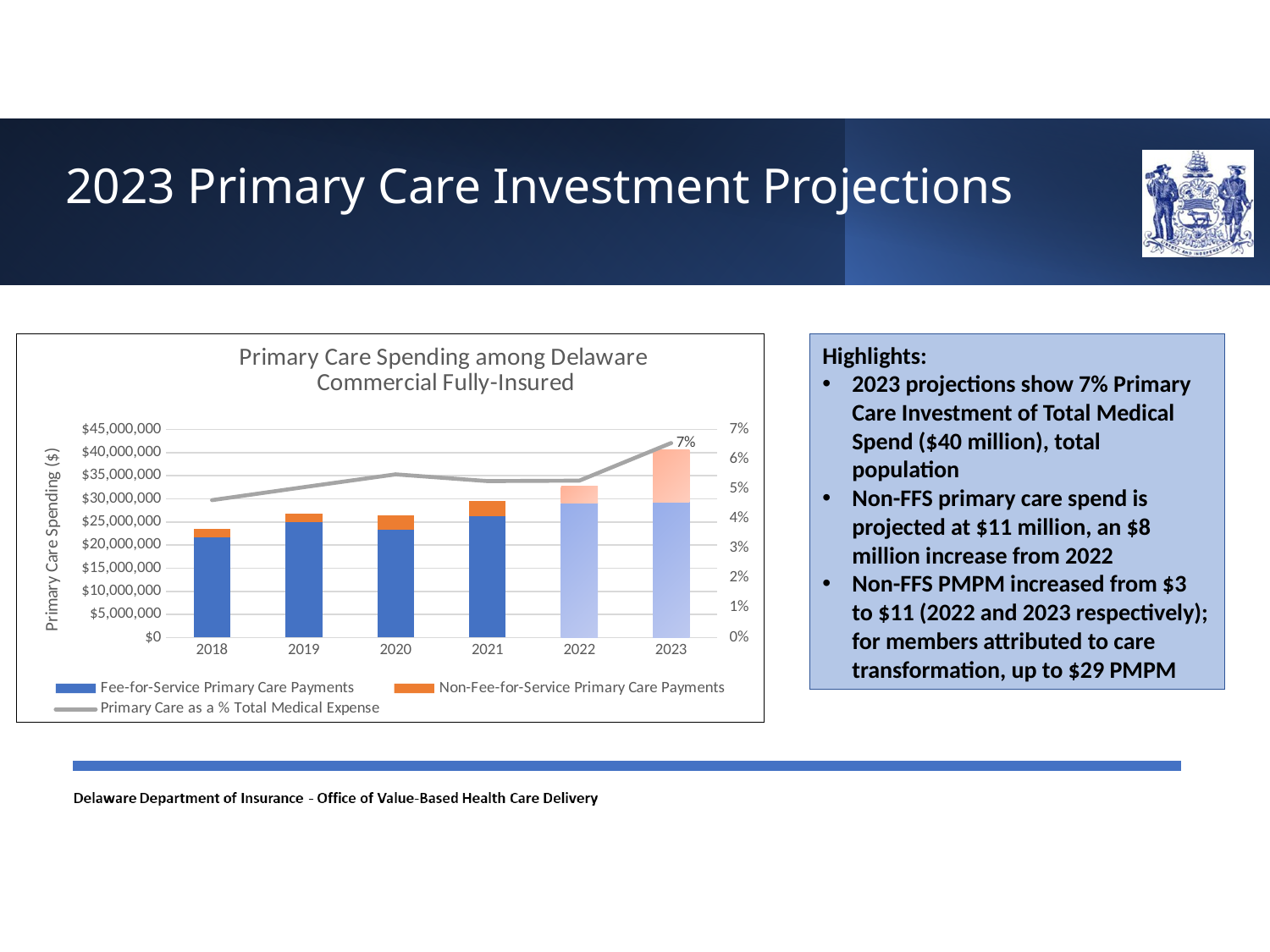
Is the total primary care spending bar for 2023 greater or less than $35,000,000? greater Which year has the highest total primary care spending bar? 2023 What kind of chart is shown on the slide? combination bar and line chart Is the value for Fee-for-Service Primary Care Payments in 2018 greater or less than $25,000,000? less Which legend entry is represented by the grey line in the chart? Primary Care as a % Total Medical Expense Which year has the lowest total primary care spending bar? 2018 What is the title of the chart? Primary Care Spending among Delaware Commercial Fully-Insured How many years are shown on the x axis of the chart? 6 Which year has the larger Non-Fee-for-Service Primary Care Payments segment, 2022 or 2023? 2023 Does the Primary Care as a % Total Medical Expense line rise or fall from 2021 to 2023? rise What is the value of Primary Care as a % Total Medical Expense for 2023? 7% How many series does the legend of the chart list? 3